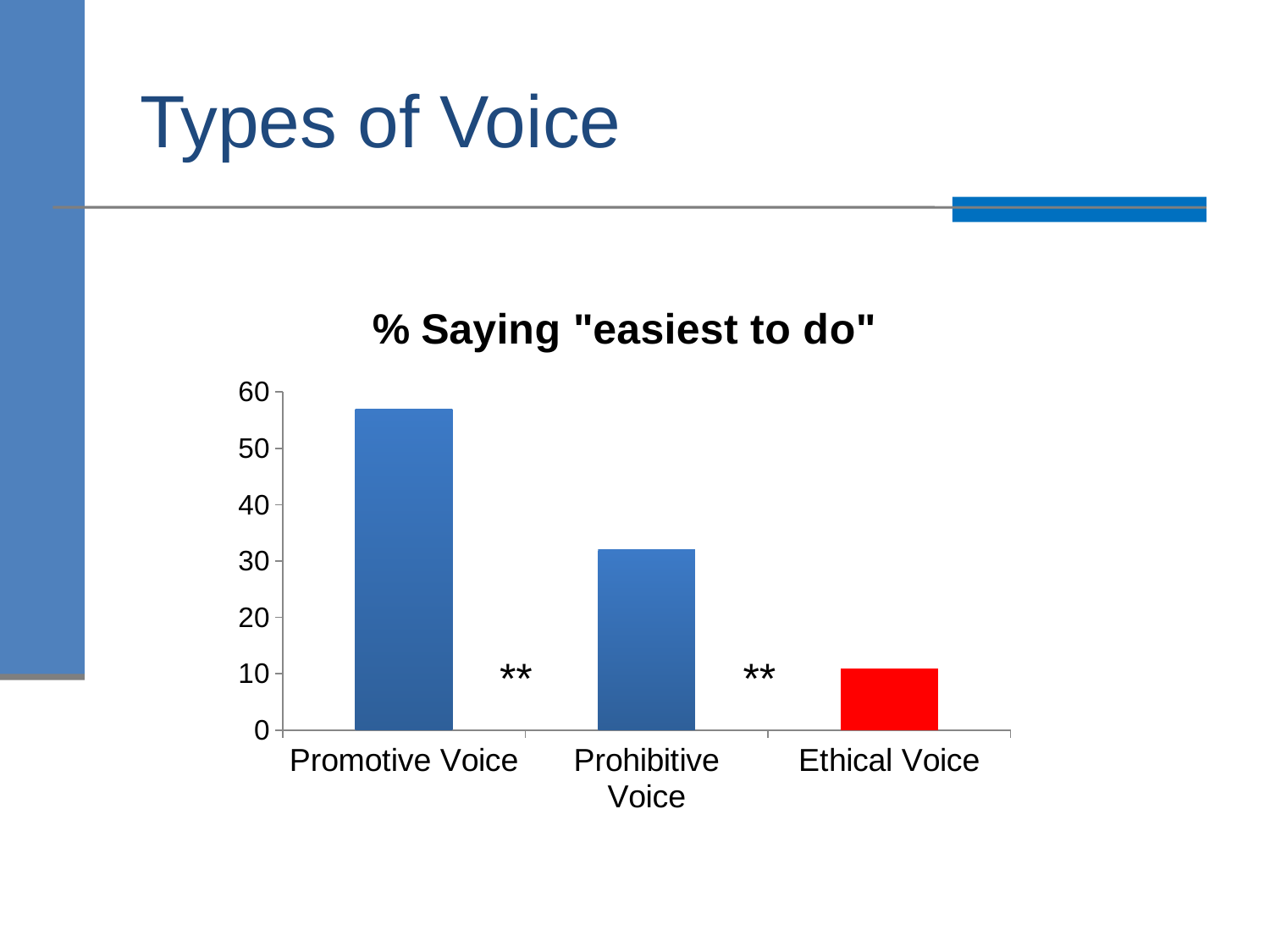
How many categories are shown on the x axis of the chart? 3 Is the value for Ethical Voice greater or less than 20? less Which category has the lowest value? Ethical Voice Is the value for Prohibitive Voice greater or less than 40? less Do the values rise or fall from left to right across the categories? fall Which is larger, the value for Prohibitive Voice or the value for Ethical Voice? Prohibitive Voice What kind of chart is shown on the slide? bar chart Is the value for Promotive Voice greater or less than 50? greater What is the title of the chart? % Saying "easiest to do" Which bar is coloured red? Ethical Voice Which category has the highest value? Promotive Voice Which is larger, the value for Promotive Voice or the value for Prohibitive Voice? Promotive Voice